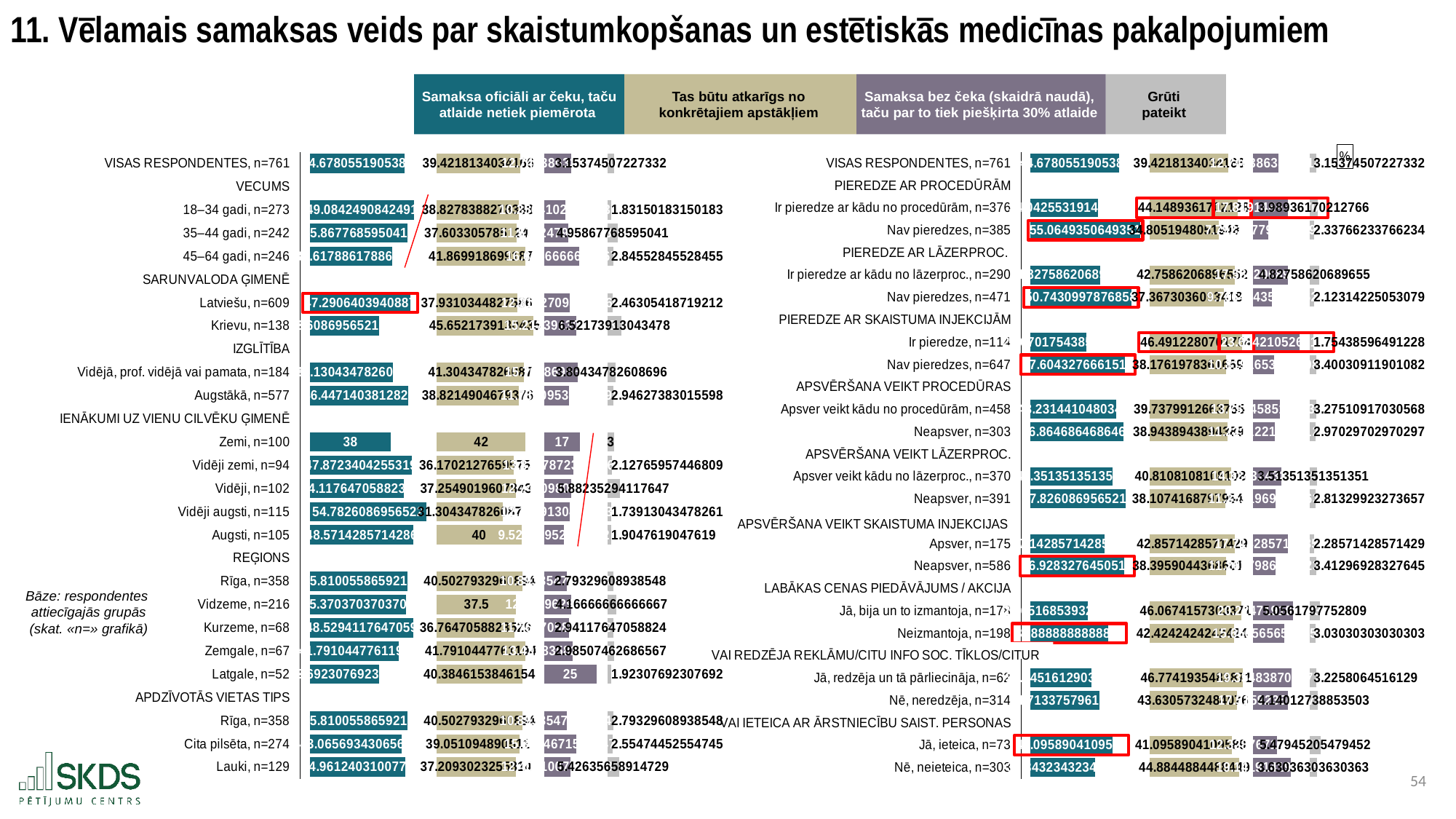
In the left chart, what is the value of 'Samaksa bez čeka (skaidrā naudā), taču par to tiek piešķirta 30% atlaide' for 'Latgale, n=52'? 25 In the left chart, for 'Zemi, n=100', which is larger: 'Samaksa oficiāli ar čeku, taču atlaide netiek piemērota' or 'Samaksa bez čeka (skaidrā naudā), taču par to tiek piešķirta 30% atlaide'? Samaksa oficiāli ar čeku, taču atlaide netiek piemērota In the left chart, what is the difference between 'Tas būtu atkarīgs no konkrētajiem apstākļiem' and 'Samaksa oficiāli ar čeku, taču atlaide netiek piemērota' for 'Zemi, n=100'? 4 In the left chart, what is the value of 'Grūti pateikt' for 'Zemi, n=100'? 3 In the left chart, which series has the highest value in the 'Zemi, n=100' bar? Tas būtu atkarīgs no konkrētajiem apstākļiem In the left chart, what is the value of 'Samaksa oficiāli ar čeku, taču atlaide netiek piemērota' for 'Zemi, n=100'? 38 In the left chart, what is the total of the stacked bar for 'Zemi, n=100'? 100 What kind of chart is used on this slide? Stacked bar chart In the left chart, what is the value of 'Samaksa bez čeka (skaidrā naudā), taču par to tiek piešķirta 30% atlaide' for 'Zemi, n=100'? 17 In the left chart, what is the value of 'Tas būtu atkarīgs no konkrētajiem apstākļiem' for 'Zemi, n=100'? 42 In the left chart, what is the value of 'Tas būtu atkarīgs no konkrētajiem apstākļiem' for 'Vidzeme, n=216'? 37.5 How many series does the legend at the top of the slide list? 4